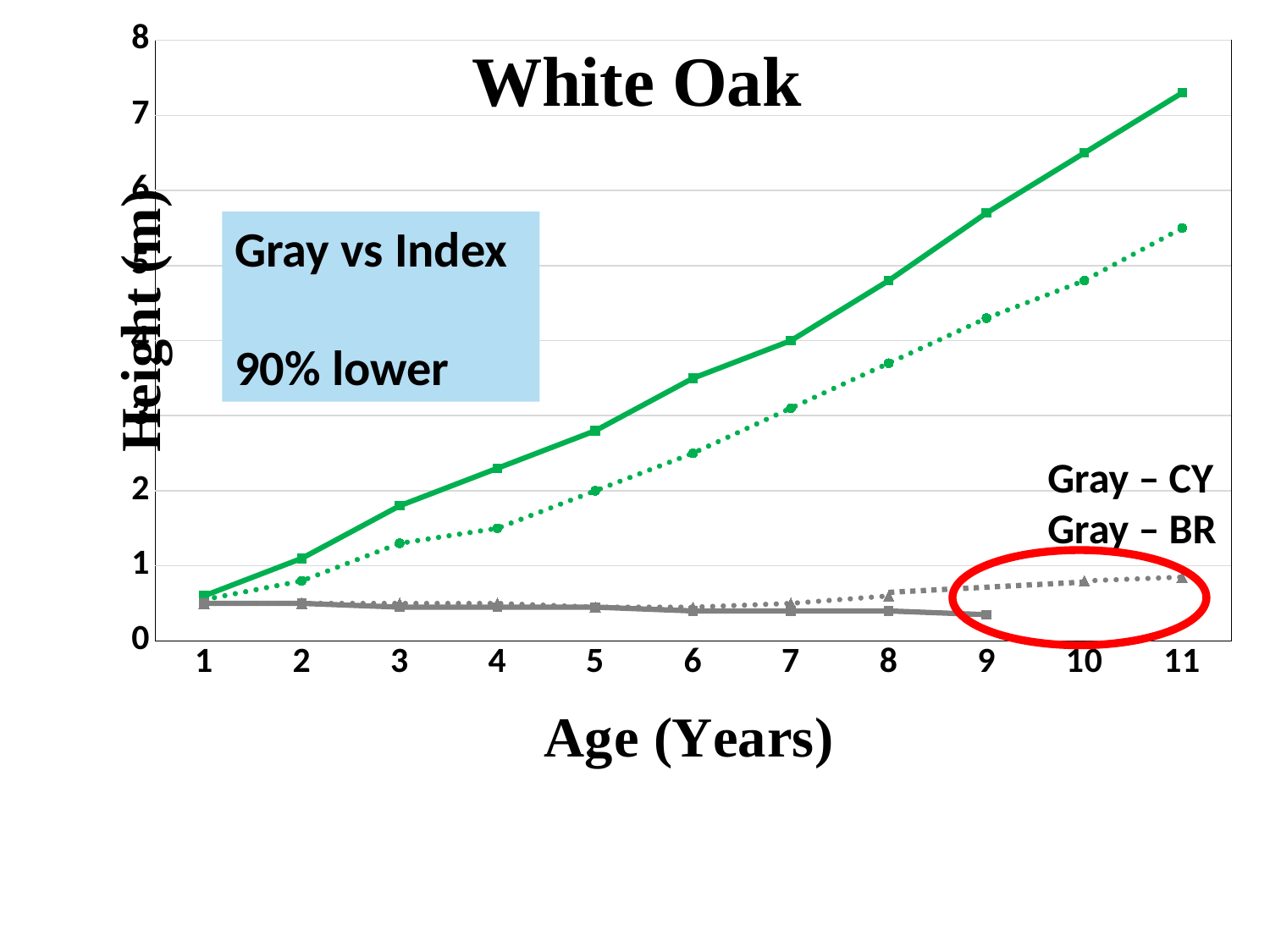
At age 11, which is higher: the solid green line or the dotted green line? the solid green line How many lines are plotted on the chart? 4 What is the label of the x axis? Age (Years) What is the title of the chart? White Oak Is the value of the solid green line at age 11 greater or less than 7? greater Does the Gray – BR line rise or fall from age 1 to age 9? falls Is the value of the dotted green line at age 11 greater or less than 6? less Which line has the lowest value at age 9? Gray – BR How many age values are shown along the x axis? 11 Does the solid green line rise or fall as age increases? rises Is the value of the Gray – CY line at age 11 greater or less than 1? less What kind of chart is shown on the slide? line chart